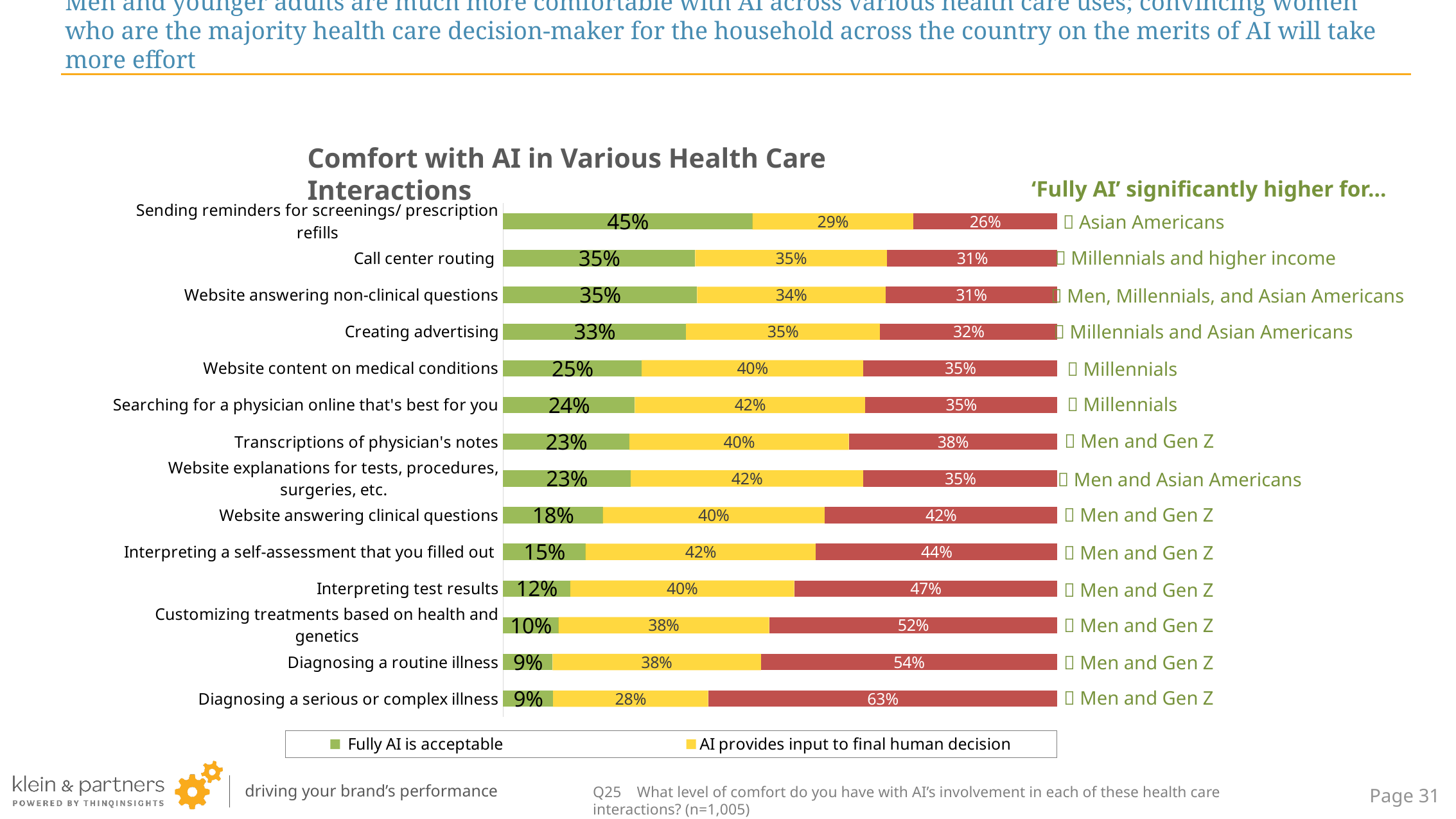
How many categories are shown in the chart? 14 What kind of chart is shown on the slide? Stacked bar chart What is the red segment value for 'Diagnosing a serious or complex illness'? 63% Which category has the lowest red segment value? Sending reminders for screenings/ prescription refills Which has a larger 'Fully AI is acceptable' value: 'Website content on medical conditions' or 'Website answering clinical questions'? Website content on medical conditions Which category has the highest 'Fully AI is acceptable' value? Sending reminders for screenings/ prescription refills What is the 'Fully AI is acceptable' value for 'Sending reminders for screenings/ prescription refills'? 45% What is the 'AI provides input to final human decision' value for 'Interpreting test results'? 40% Which colour represents 'Fully AI is acceptable' in the chart? Green What is the title of the chart? Comfort with AI in Various Health Care Interactions What is the total of the stacked bar for 'Creating advertising'? 100% What is the difference between the 'Fully AI is acceptable' values for 'Call center routing' and 'Interpreting test results'? 23%